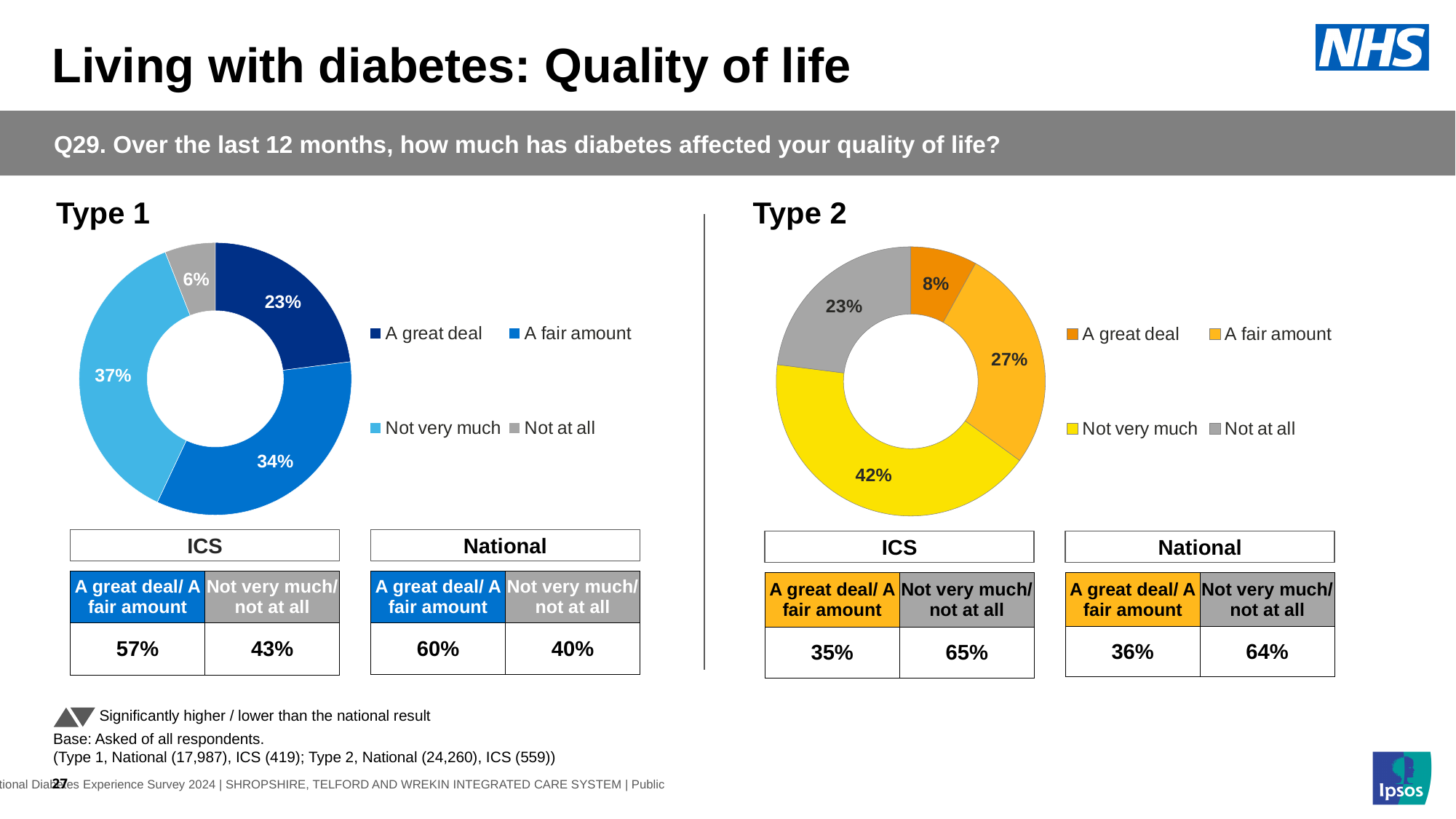
In the Type 1 chart, what is the difference between the 'Not very much' and 'Not at all' shares? 31 percentage points In the Type 1 chart, what is the 'Not at all' share? 6% In the Type 2 chart, what is the combined share of 'A great deal' and 'A fair amount'? 35% In the Type 2 chart, what colour represents 'Not very much'? Yellow What kind of chart is used for Type 2? Doughnut chart In the Type 2 chart, which is larger: 'A fair amount' or 'Not at all'? A fair amount How many legend entries does the Type 1 chart have? 4 In the Type 1 chart, what percentage of respondents said 'A great deal'? 23% In the Type 2 chart, which category has the smallest share? A great deal In the Type 1 chart, which category has the largest share? Not very much How many categories does the Type 1 chart show? 4 In the Type 2 chart, what percentage of respondents said 'Not very much'? 42%